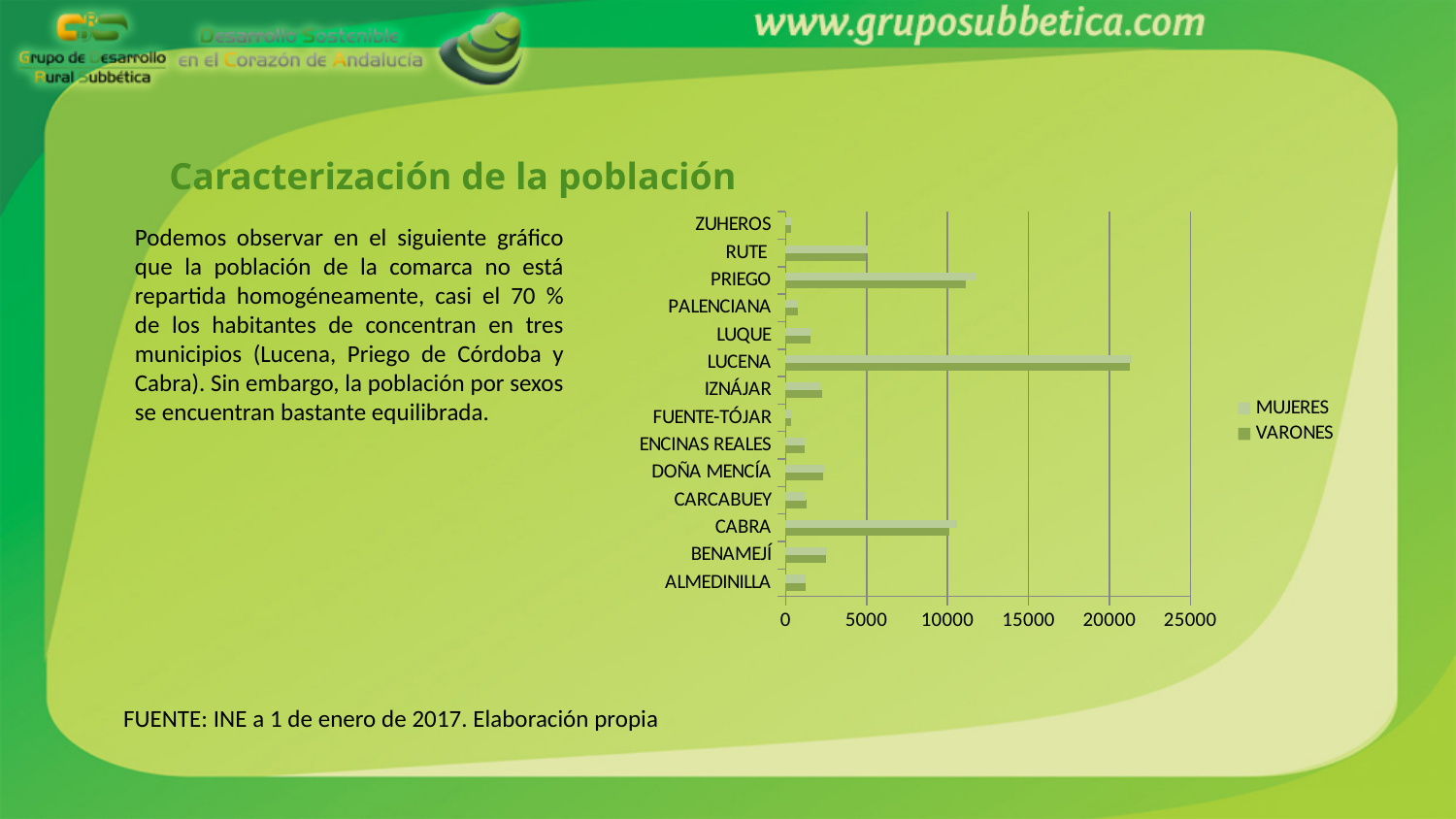
What are the two series named in the chart legend? MUJERES and VARONES Is the value for LUCENA greater or less than 20000? greater Which municipality has the highest population values in the chart? LUCENA What is the highest value shown on the horizontal axis of the chart? 25000 Which has a larger population, IZNÁJAR or PALENCIANA? IZNÁJAR What kind of chart is shown on the slide? bar chart Which has a larger population, LUCENA or PRIEGO? LUCENA Is the value for PRIEGO greater or less than 15000? less Is the value for PRIEGO greater or less than 10000? greater How many series does the chart legend list? 2 How many municipalities are listed on the vertical axis of the chart? 14